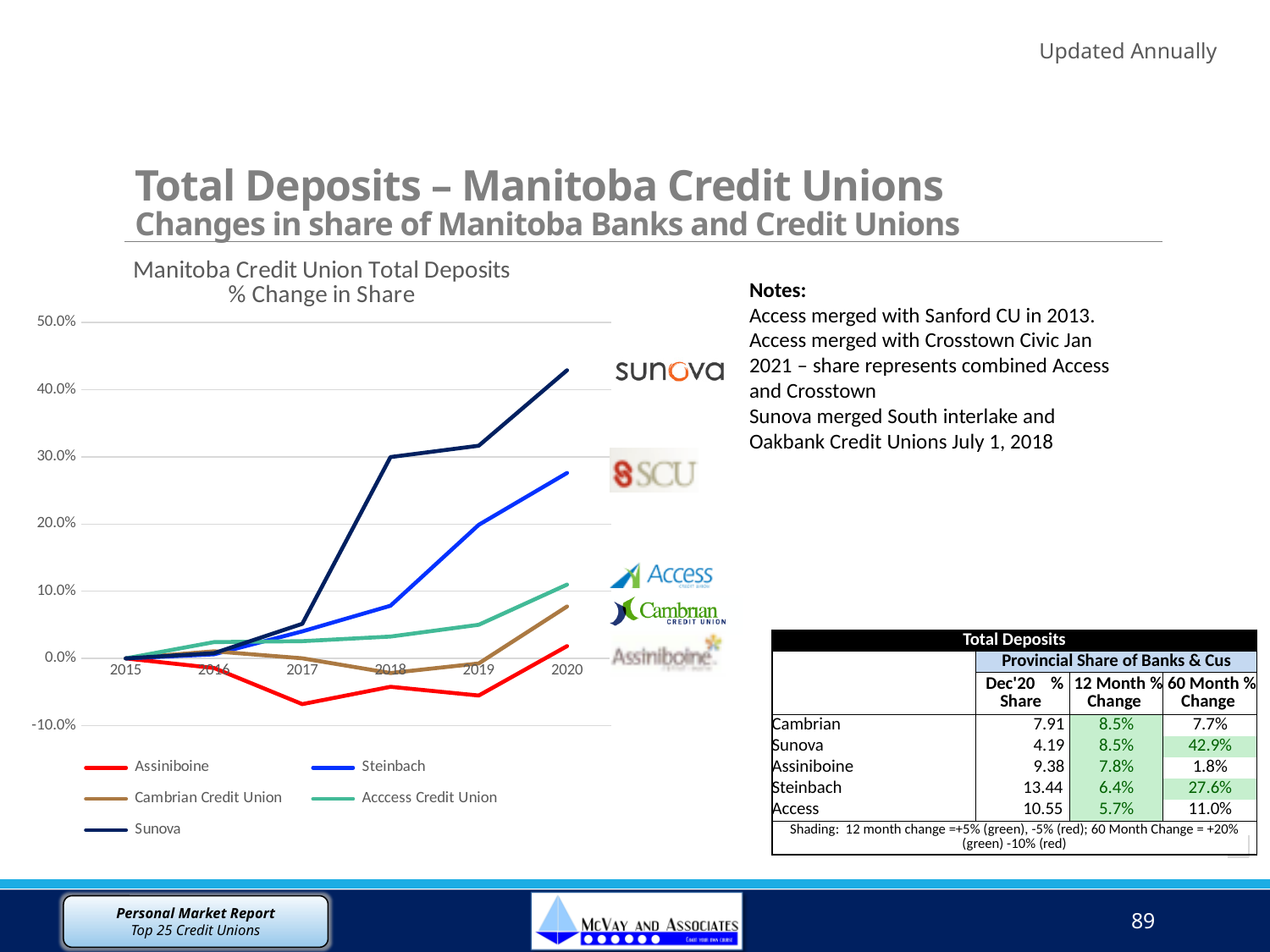
Which credit union has the lowest % change in share in 2020? Assiniboine What kind of chart is shown on the slide? line chart How many series does the chart legend list? 5 Is the value for Assiniboine in 2017 greater or less than 0.0%? less Is the value for Sunova in 2020 greater or less than 40.0%? greater Is the value for Cambrian Credit Union in 2020 greater or less than 10.0%? less What is the title of the chart? Manitoba Credit Union Total Deposits % Change in Share Does the Sunova line rise or fall from 2017 to 2020? rise How many years are shown on the x axis of the chart? 6 Which credit union has the highest % change in share in 2020? Sunova Which is larger in 2020, the value for Steinbach or the value for Acccess Credit Union? Steinbach